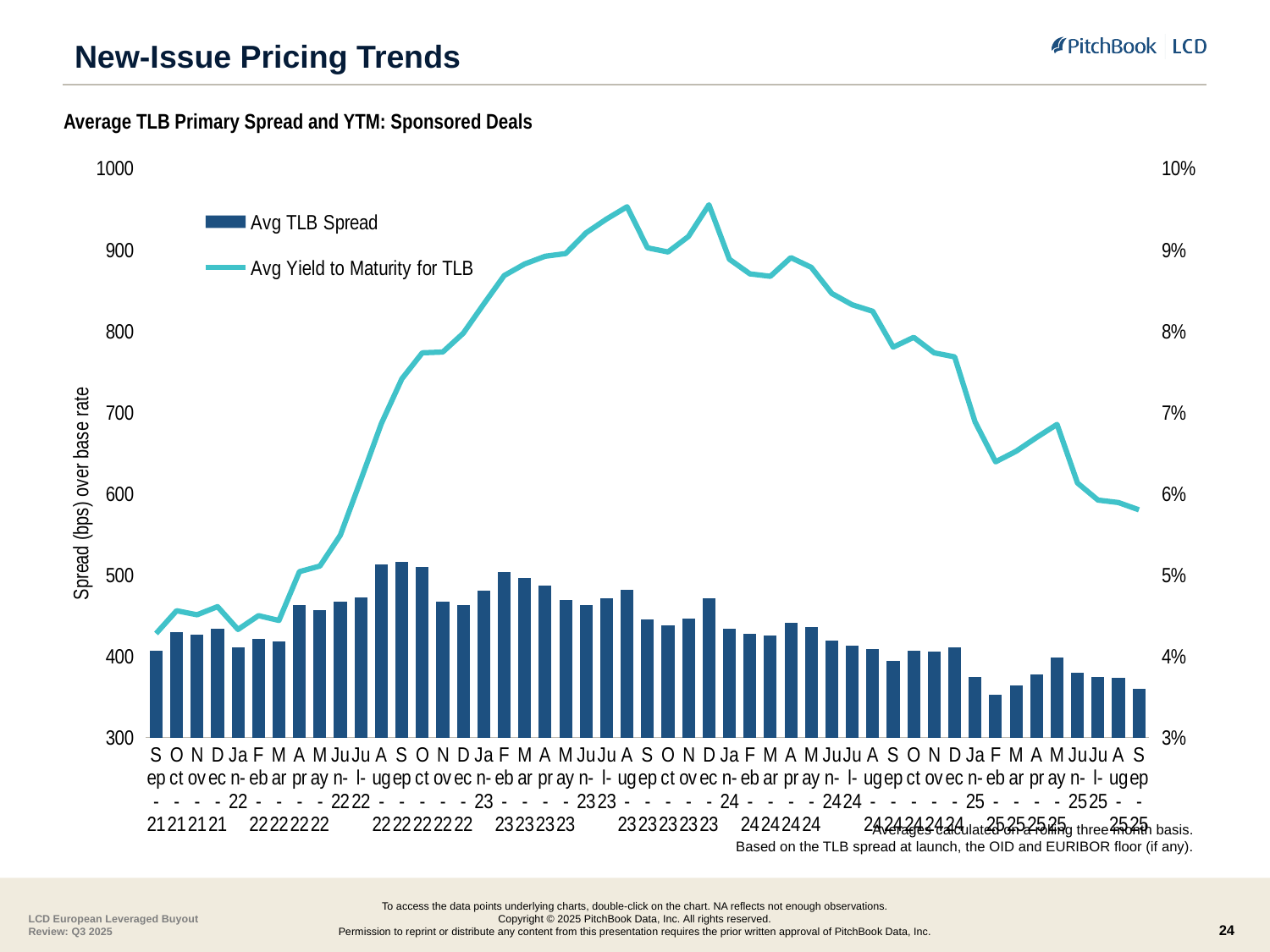
How many series does the legend list? 2 Is the Avg TLB Spread bar for Aug-22 greater or less than 500? greater What is the title of the chart? Average TLB Primary Spread and YTM: Sponsored Deals Does the Avg Yield to Maturity for TLB line rise or fall between Sep-21 and Aug-23? rise Is the Avg TLB Spread bar for Feb-25 greater or less than 400? less Which is larger, the Avg TLB Spread bar for Aug-22 or for Feb-25? Aug-22 What is the label on the left vertical axis? Spread (bps) over base rate What kind of chart is shown on the slide? A combined bar and line chart Does the Avg Yield to Maturity for TLB line rise or fall between Dec-23 and Sep-25? fall Is the Avg Yield to Maturity for TLB in Sep-21 greater or less than 5%? less